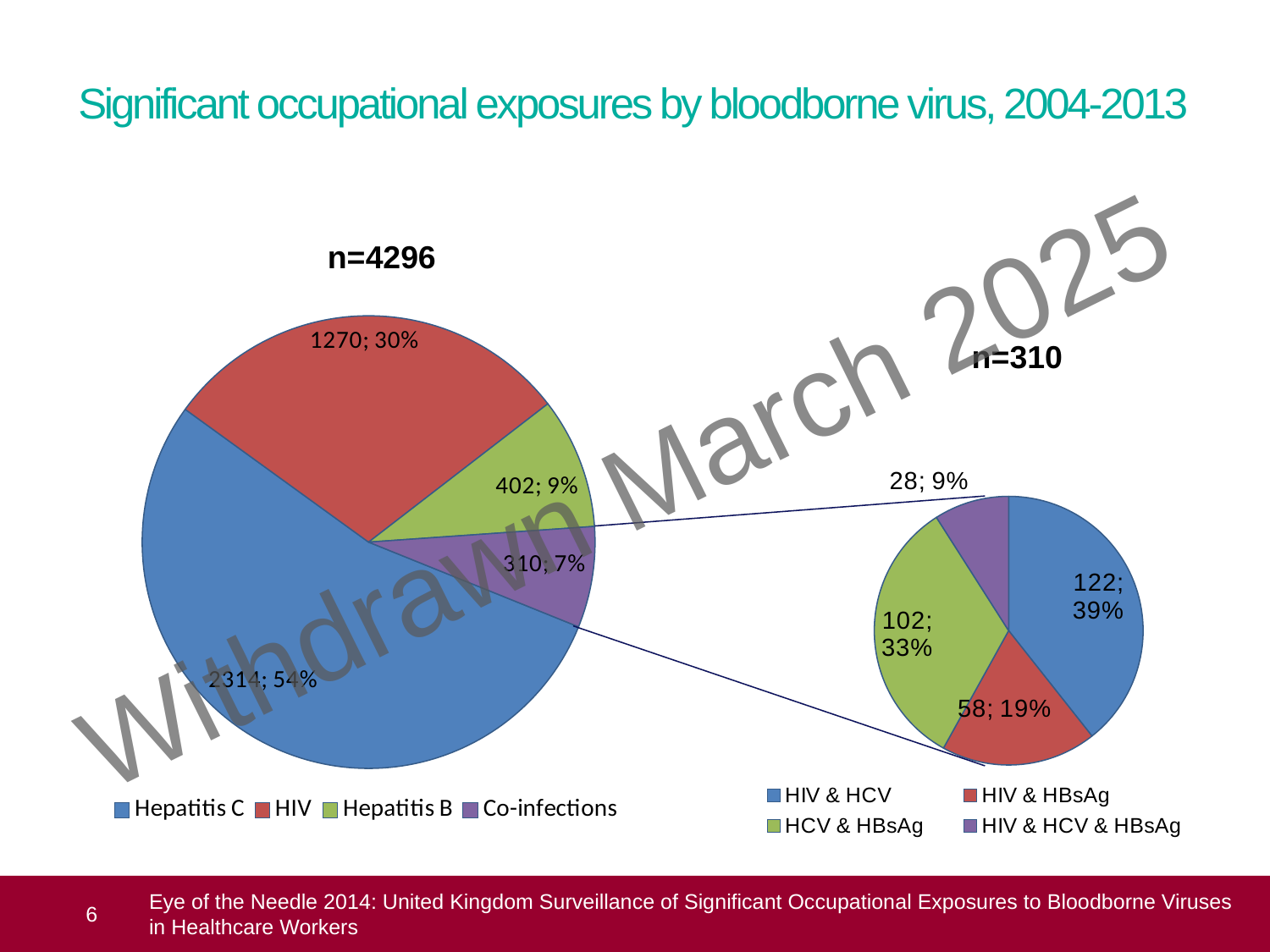
In the left pie chart (n=4296), which category has the largest slice? Hepatitis C In the right pie chart (n=310), how many exposures were for HIV & HCV? 122 What is the title of the slide? Significant occupational exposures by bloodborne virus, 2004-2013 In the right pie chart (n=310), which is larger: HIV & HBsAg or HCV & HBsAg? HCV & HBsAg In the left pie chart (n=4296), how many significant occupational exposures were for Hepatitis C? 2314 How many categories does the legend of the right pie chart (n=310) list? 4 In the left pie chart (n=4296), what percentage of exposures were for HIV? 30% In the left pie chart (n=4296), what is the difference between the number of HIV exposures and Hepatitis B exposures? 868 In the right pie chart (n=310), what percentage of co-infection exposures were HCV & HBsAg? 33% In the left pie chart (n=4296), which category has the smallest slice? Co-infections What type of chart is used on this slide? Pie chart In the right pie chart (n=310), which co-infection category has the fewest exposures? HIV & HCV & HBsAg